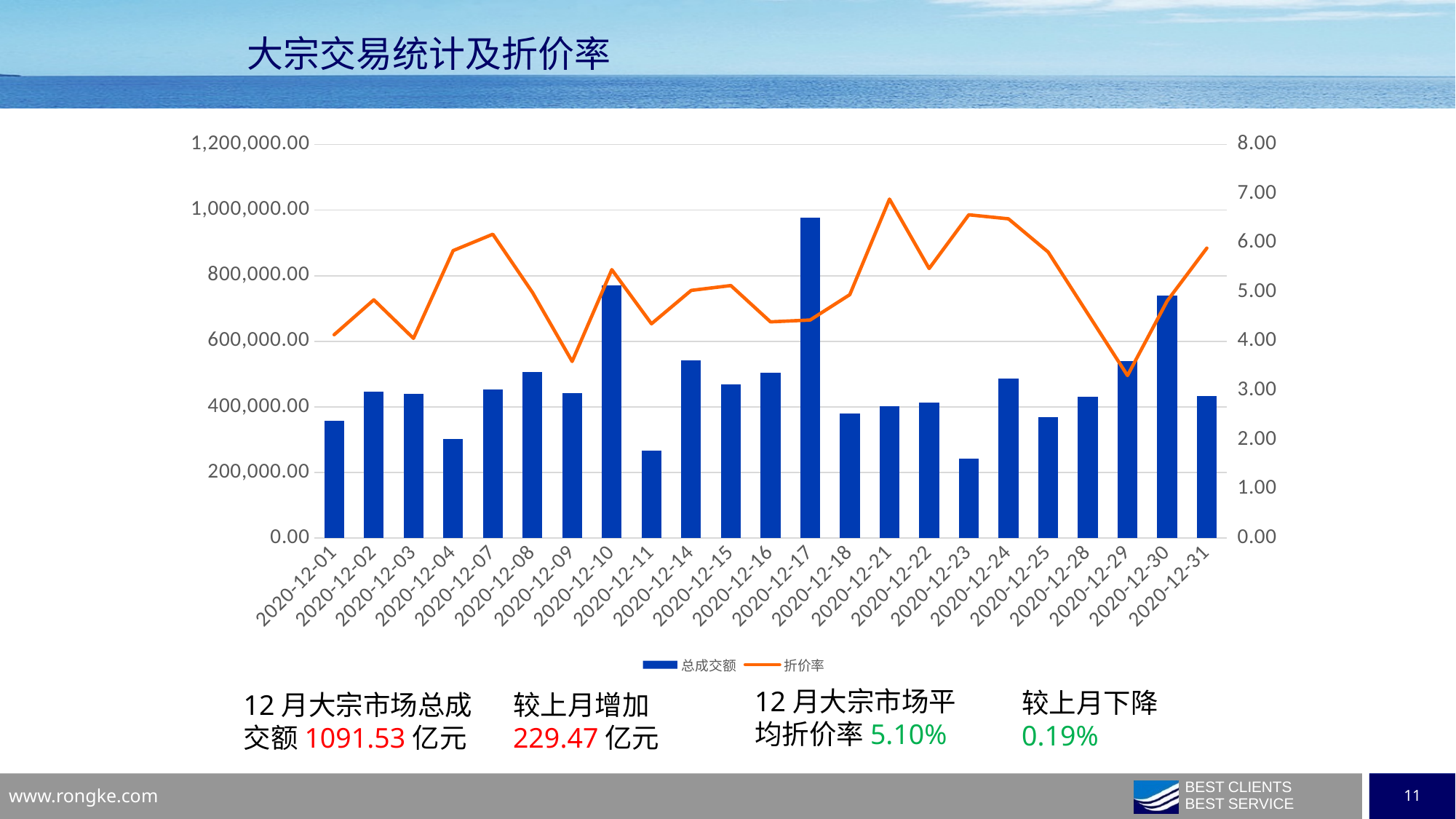
Is the 折价率 value for 2020-12-21 greater or less than 6.00? greater On which date is the 总成交额 bar the lowest? 2020-12-23 On which date does the 折价率 line reach its lowest point? 2020-12-29 How many series does the legend list? 2 On which date is the 总成交额 bar the highest? 2020-12-17 Which has the larger 总成交额 bar, 2020-12-17 or 2020-12-30? 2020-12-17 Is the 总成交额 value for 2020-12-23 greater or less than 400,000.00? less What kind of chart is shown on the slide? A combination bar and line chart Is the 总成交额 value for 2020-12-17 greater or less than 800,000.00? greater On which date does the 折价率 line reach its highest point? 2020-12-21 How many dates are shown on the x axis? 23 What are the two series named in the legend? 总成交额 and 折价率